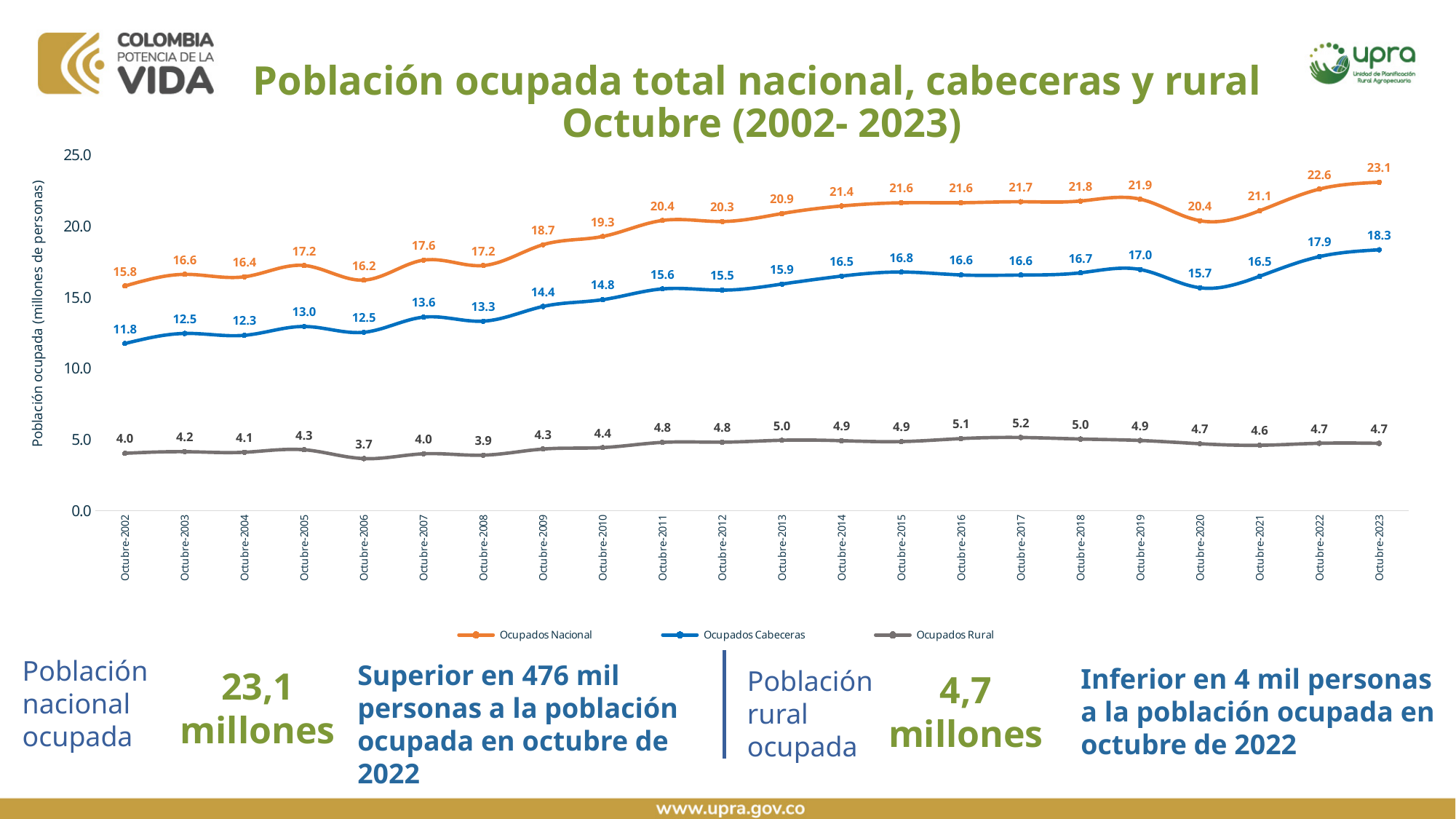
What kind of chart is shown on the slide? line chart Which colour is used for the Ocupados Cabeceras series? blue Is the value of Ocupados Nacional for Octubre-2011 greater or less than 20.0? greater In which year does Ocupados Rural reach its highest value? Octubre-2017 How many years are shown on the x axis? 22 What is the difference between Ocupados Nacional in Octubre-2023 and Octubre-2022? 0.5 How many series does the legend list? 3 In which year is Ocupados Nacional at its lowest value? Octubre-2002 Which is larger: Ocupados Cabeceras in Octubre-2019 or in Octubre-2020? Octubre-2019 What is the value of Ocupados Nacional for Octubre-2023? 23.1 What is the value of Ocupados Rural for Octubre-2006? 3.7 What is the value of Ocupados Cabeceras for Octubre-2002? 11.8